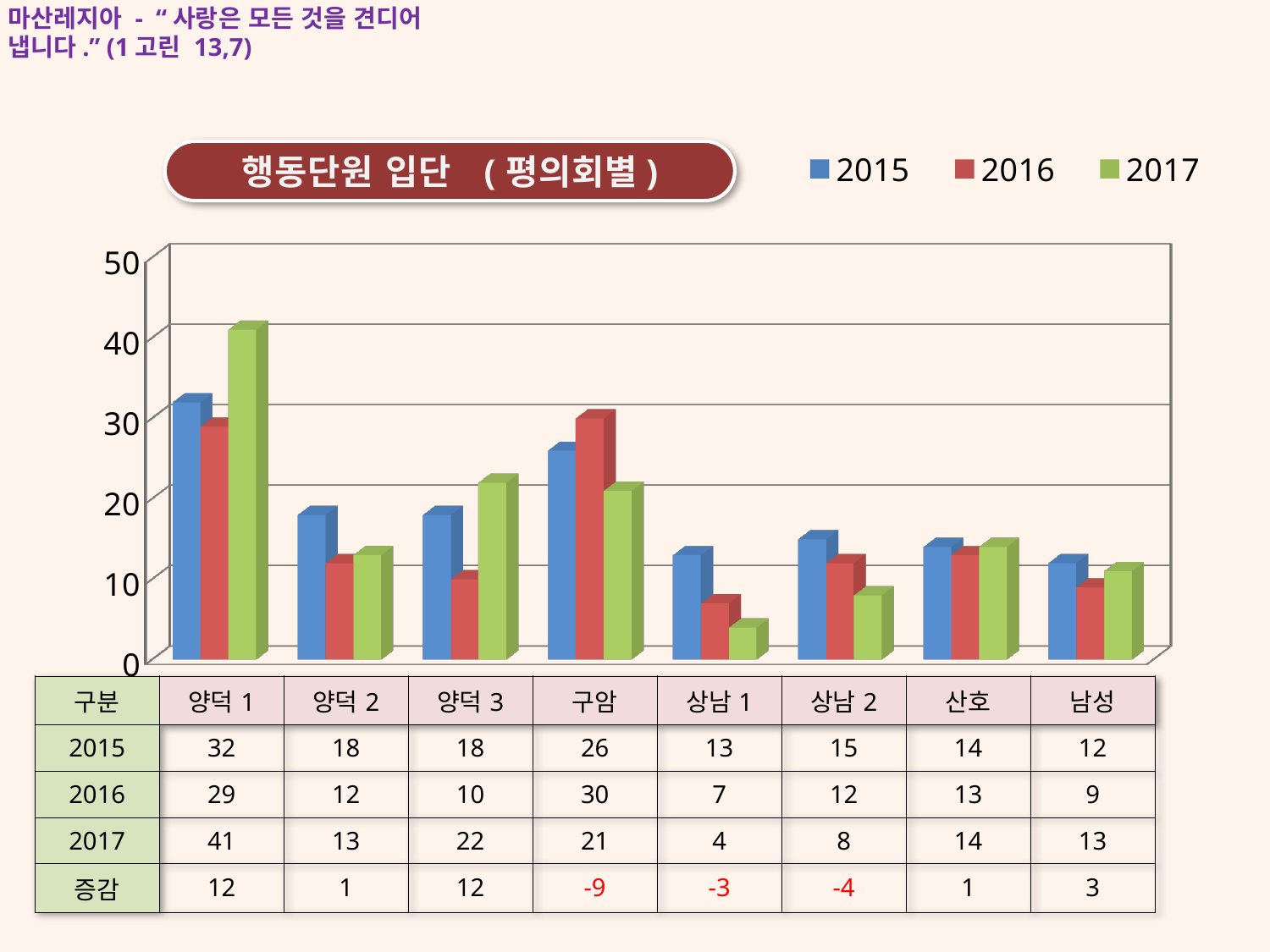
How many series does the legend list? 3 How many categories are shown on the x axis of the chart? 8 What is the title of the chart? 행동단원 입단 (평의회별) Which colour represents the 2016 series in the chart? red Which category has the highest 2017 value? 양덕 1 What is the 2017 value for 양덕 1? 41 What is the 2015 value for 상남 2? 15 What is the 2016 value for 구암? 30 What kind of chart is shown on the slide? bar chart Which category has the lowest 2017 value? 상남 1 Which is larger for 구암: the 2015 value or the 2016 value? 2016 What is the difference between the 2017 and 2015 values for 양덕 3? 4